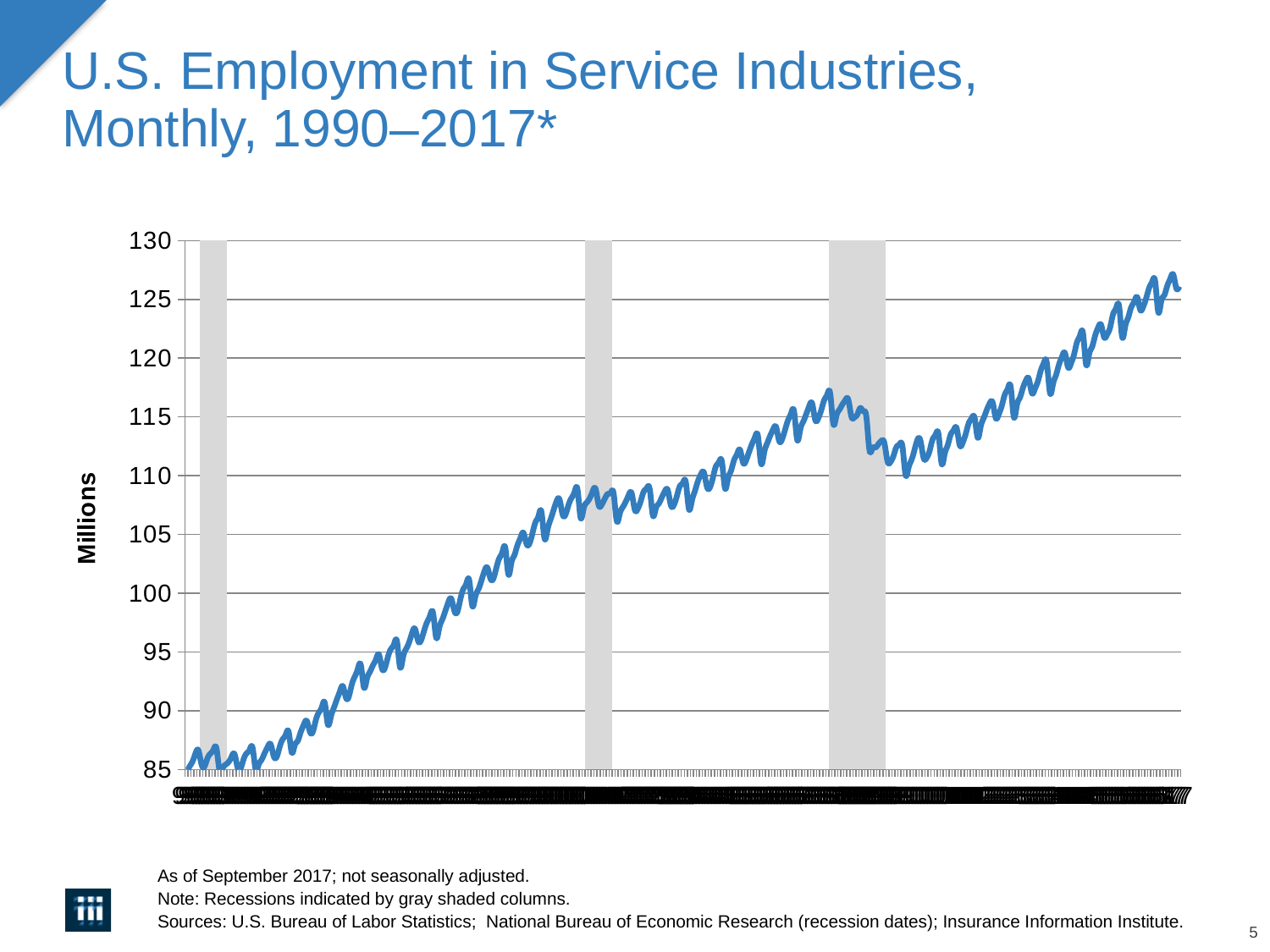
Is the value at the end of the third (rightmost) gray shaded recession column greater or less than 115? less Is the value at the end of the series (2017) greater or less than 130? less Is the value at the end of the series (2017) greater or less than 120? greater Overall, do the values rise or fall from 1990 to 2017? rise What is the label on the vertical axis? Millions What is the title of the chart? U.S. Employment in Service Industries, Monthly, 1990–2017* What kind of chart is shown on the slide? line chart